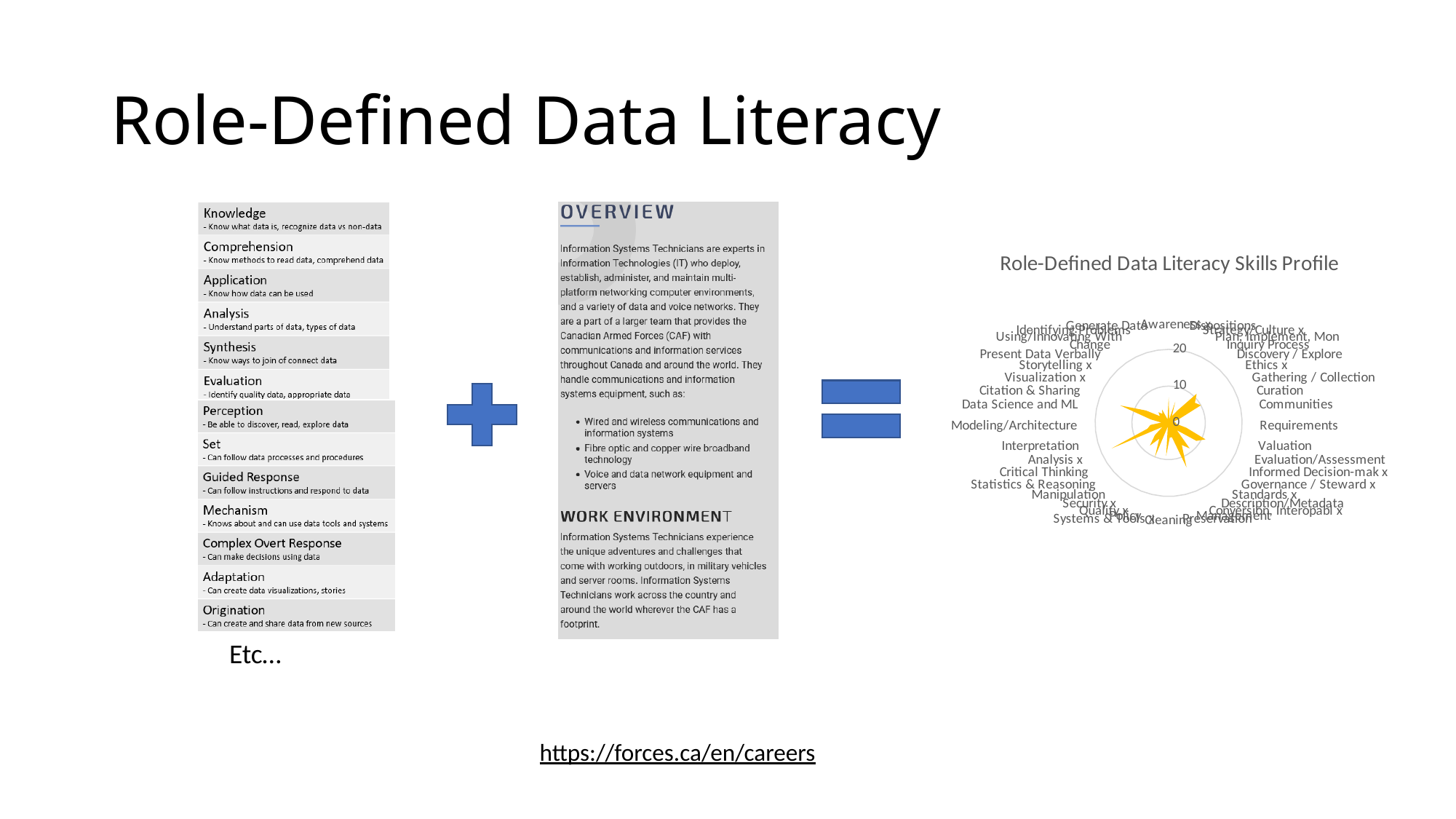
What is the title of the chart on the right side of the slide? Role-Defined Data Literacy Skills Profile What kind of chart is the Role-Defined Data Literacy Skills Profile? Radar chart In the Role-Defined Data Literacy Skills Profile chart, what is the highest value labelled on the radial axis? 20 In the Role-Defined Data Literacy Skills Profile chart, is the largest plotted value greater or less than 20? less